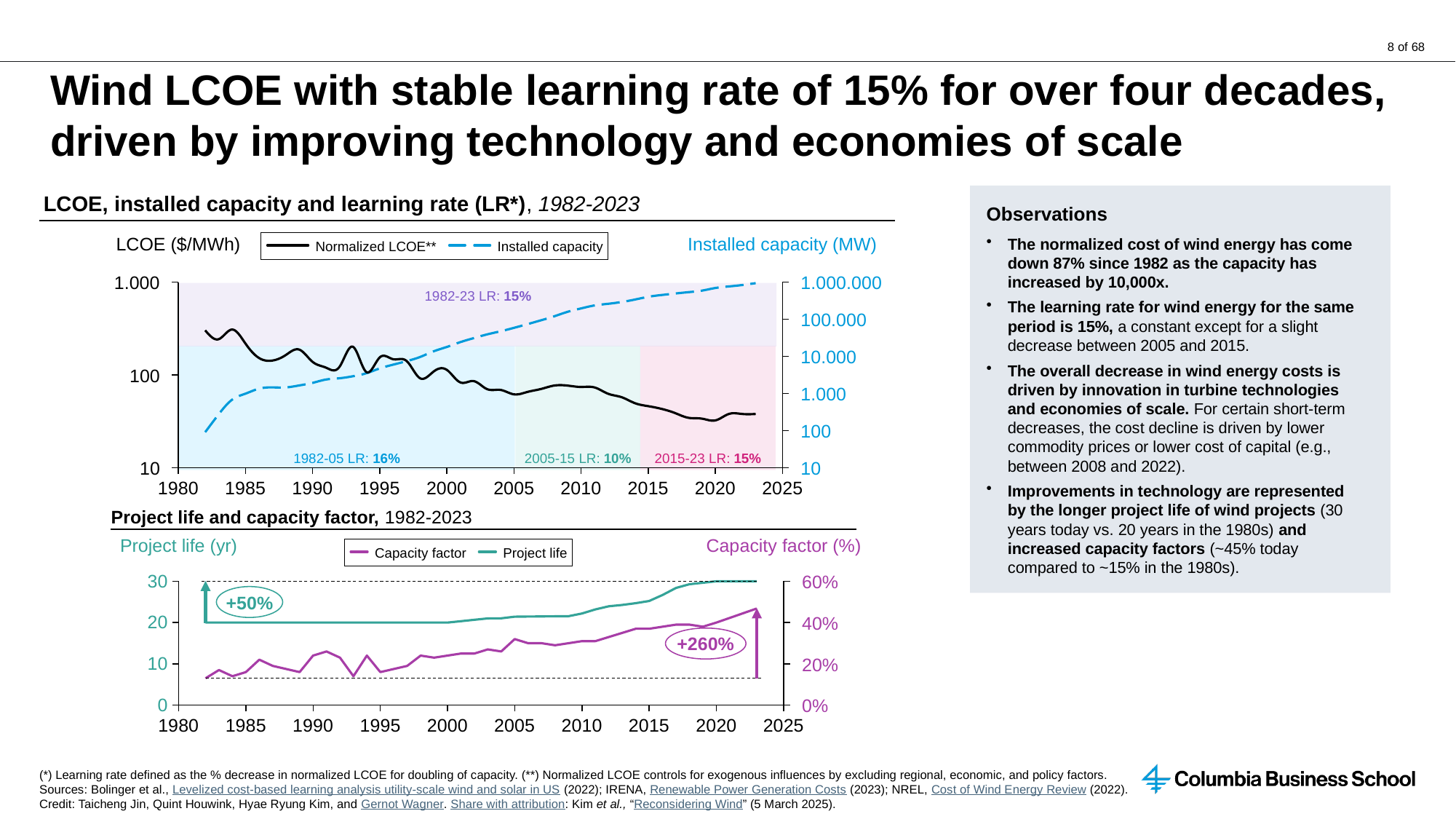
What type of chart is the top chart titled 'LCOE, installed capacity and learning rate (LR*), 1982-2023'? Line chart In the top chart, does the Installed capacity line rise or fall from 1982 to 2023? Rise In the top chart (LCOE, installed capacity and learning rate), how many series does the legend list? 2 In the top chart, what is the learning rate shown for the full period 1982-23? 15% In the bottom chart (Project life and capacity factor), how many series does the legend list? 2 In the bottom chart, what percentage increase is annotated for Project life? +50% In the top chart, what is the learning rate shown for 1982-05? 16% In the top chart, does the Normalized LCOE line rise or fall from 1982 to 2023? Fall In the bottom chart, is the Capacity factor value in 2023 greater or less than 40%? greater In the top chart, which is higher: Normalized LCOE in 1982 or in 2023? 1982 In the top chart, what is the learning rate shown for 2005-15? 10% In the bottom chart, what percentage increase is annotated for Capacity factor? +260%